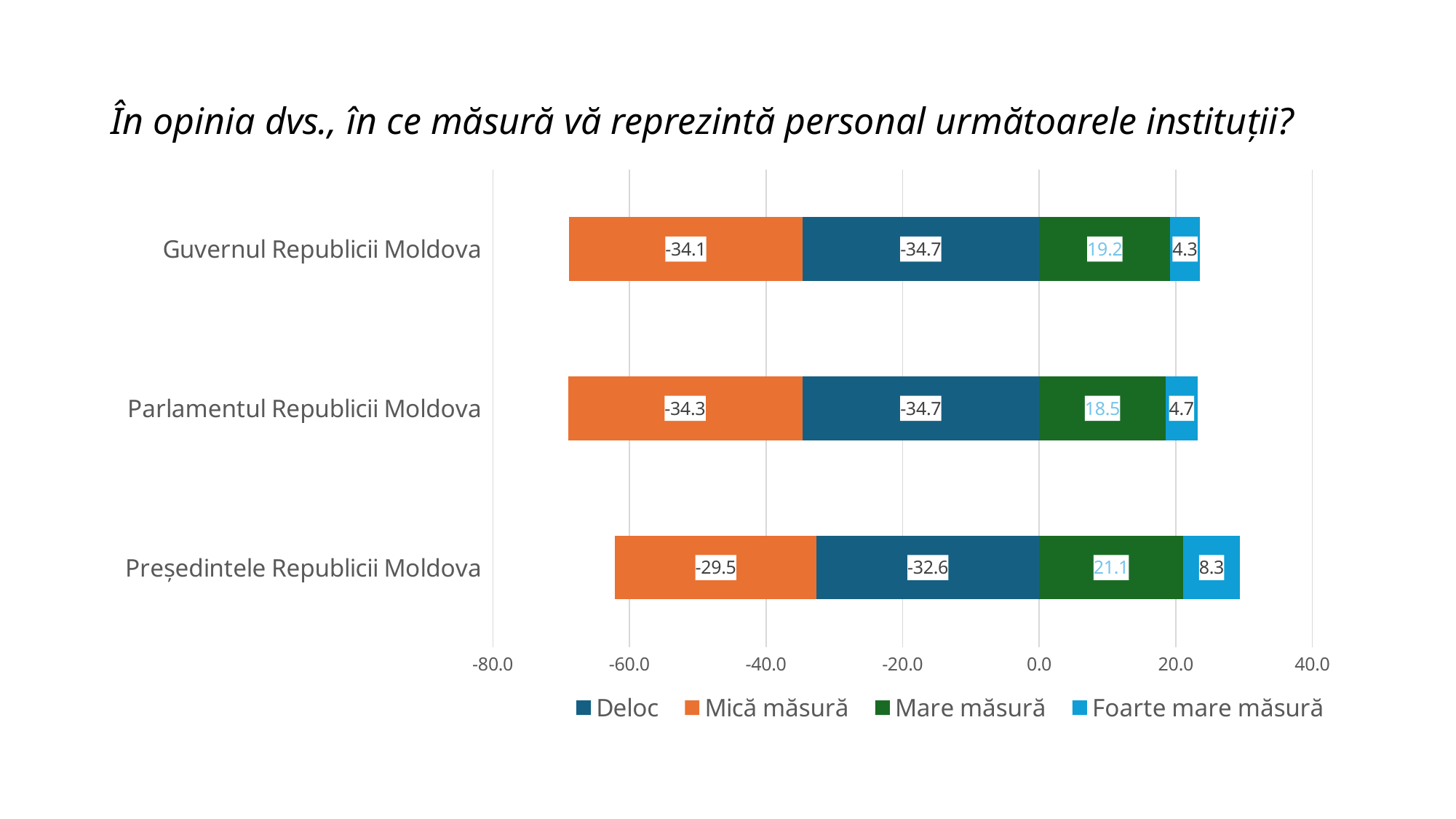
What is the difference between the Mare măsură values for Președintele Republicii Moldova and Parlamentul Republicii Moldova? 2.6 What is the value of the Deloc series for Guvernul Republicii Moldova? -34.7 Which institution has the lowest value for the Mare măsură series? Parlamentul Republicii Moldova What is the value of the Foarte mare măsură series for Parlamentul Republicii Moldova? 4.7 What is the value of the Mică măsură series for Președintele Republicii Moldova? -29.5 Which institution has the highest value for the Foarte mare măsură series? Președintele Republicii Moldova Which has the larger Mare măsură value, Guvernul Republicii Moldova or Parlamentul Republicii Moldova? Guvernul Republicii Moldova How many series does the legend list? 4 What kind of chart is shown on the slide? Stacked bar chart What colour represents the Mică măsură series in the legend? Orange How many institutions are shown on the chart? 3 What is the combined value of the Mare măsură and Foarte mare măsură segments for Președintele Republicii Moldova? 29.4